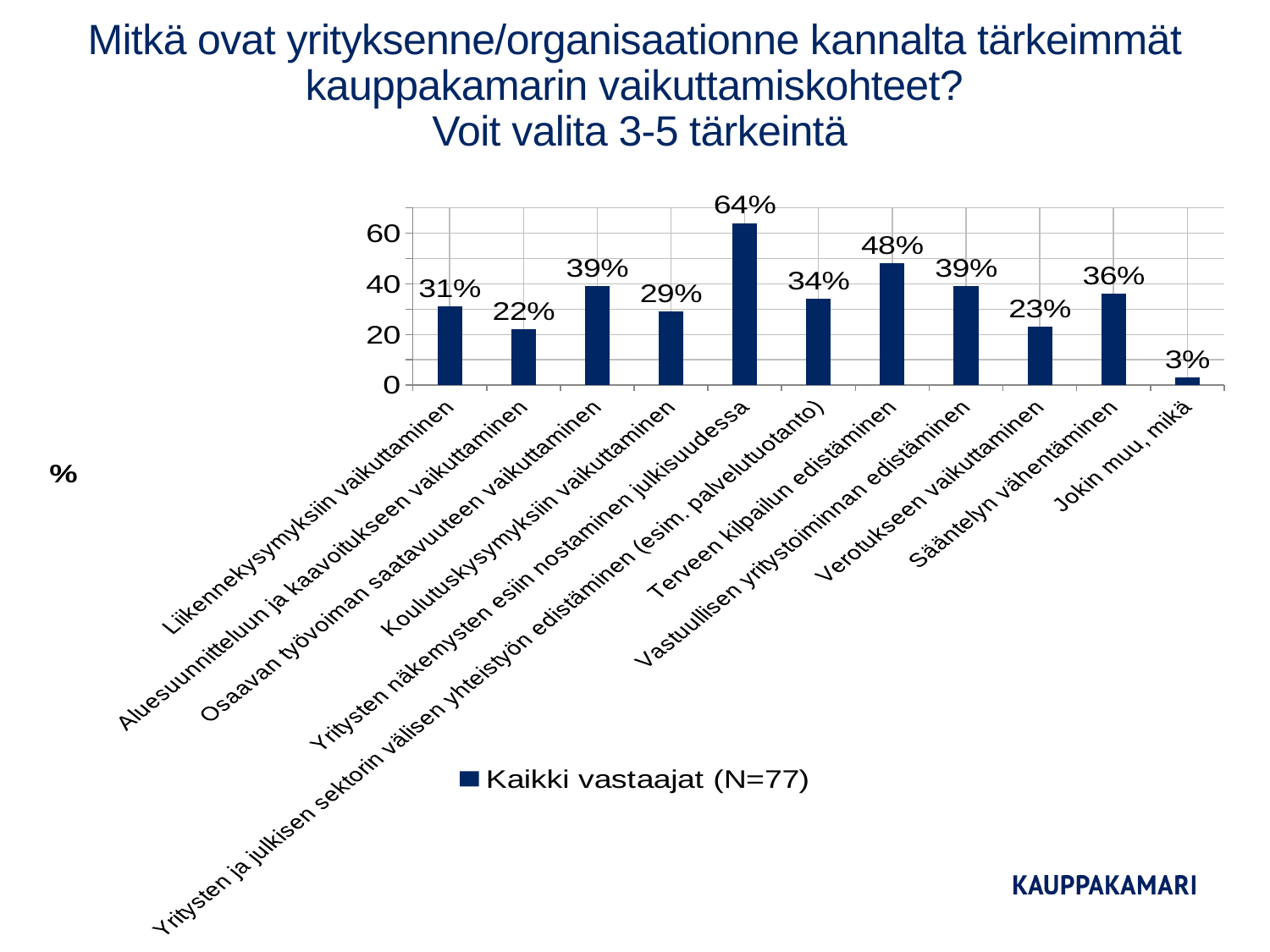
Which is larger, the value for Koulutuskysymyksiin vaikuttaminen or the value for Aluesuunnitteluun ja kaavoitukseen vaikuttaminen? Koulutuskysymyksiin vaikuttaminen How many categories are shown on the x axis? 11 What is the legend entry of the chart? Kaikki vastaajat (N=77) What is the value for Sääntelyn vähentäminen? 36% Which category has the highest value? Yritysten näkemysten esiin nostaminen julkisuudessa What kind of chart is shown on the slide? Bar chart Is the value for Yritysten ja julkisen sektorin välisen yhteistyön edistäminen (esim. palvelutuotanto) greater or less than 40? less Which category has the lowest value? Jokin muu, mikä What is the value for Terveen kilpailun edistäminen? 48% What is the value for Yritysten näkemysten esiin nostaminen julkisuudessa? 64% What is the difference between the values for Terveen kilpailun edistäminen and Liikennekysymyksiin vaikuttaminen? 17 percentage points What is the value for Verotukseen vaikuttaminen? 23%